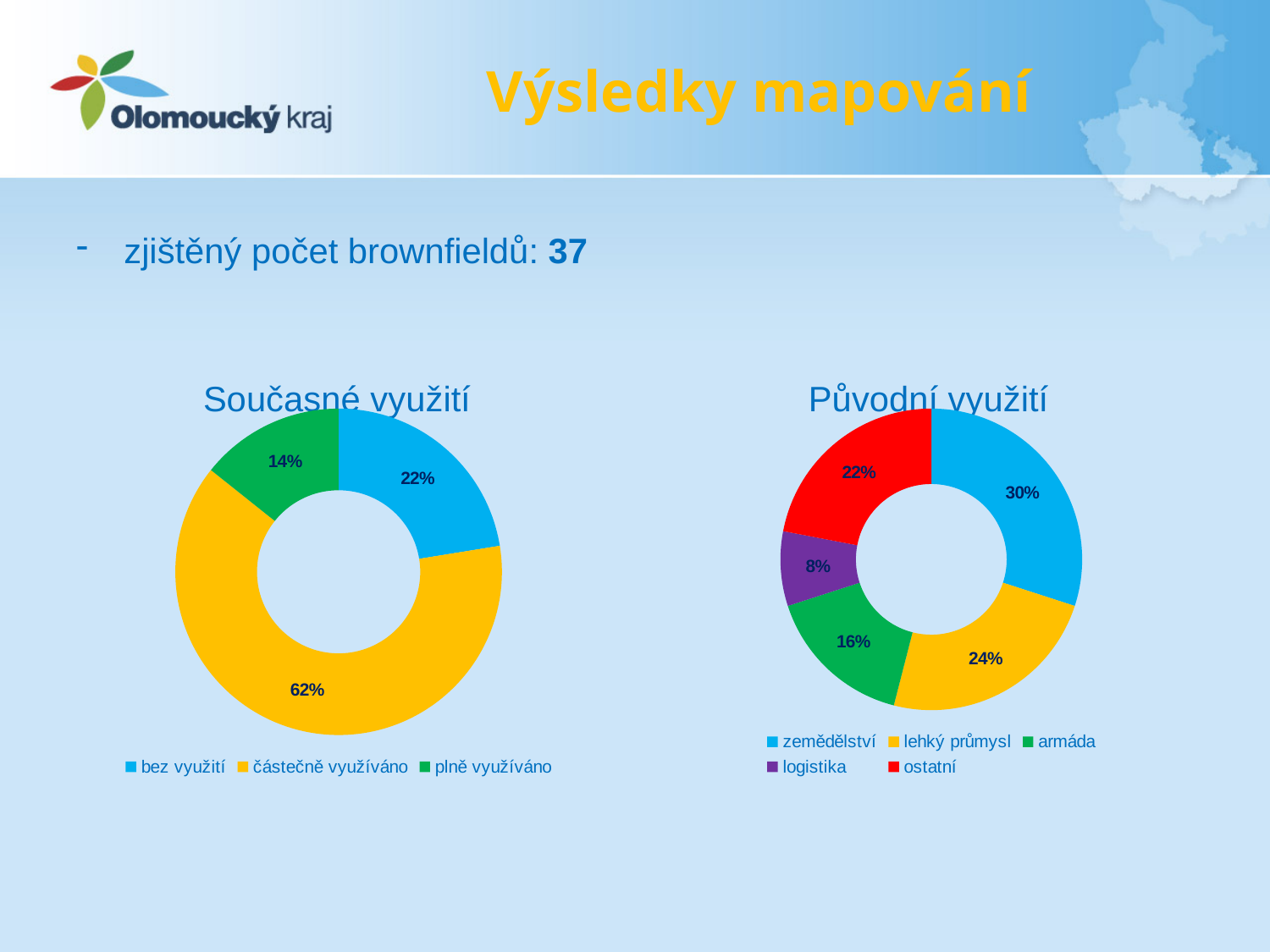
In the "Původní využití" chart, what colour represents "armáda"? Green What kind of chart is the "Současné využití" chart? Doughnut (pie) chart In the "Původní využití" chart, what percentage is shown for "zemědělství"? 30% In the "Současné využití" chart, what is the difference in percentage points between "částečně využíváno" and "bez využití"? 40 In the "Původní využití" chart, which category has the largest share? zemědělství How many categories does the "Současné využití" chart show? 3 In the "Současné využití" chart, what percentage is shown for "bez využití"? 22% How many categories does the legend of the "Původní využití" chart list? 5 In the "Současné využití" chart, what percentage is shown for "částečně využíváno"? 62% In the "Současné využití" chart, which category has the smallest share? plně využíváno In the "Původní využití" chart, which is larger: "lehký průmysl" or "ostatní"? lehký průmysl In the "Původní využití" chart, what percentage is shown for "logistika"? 8%